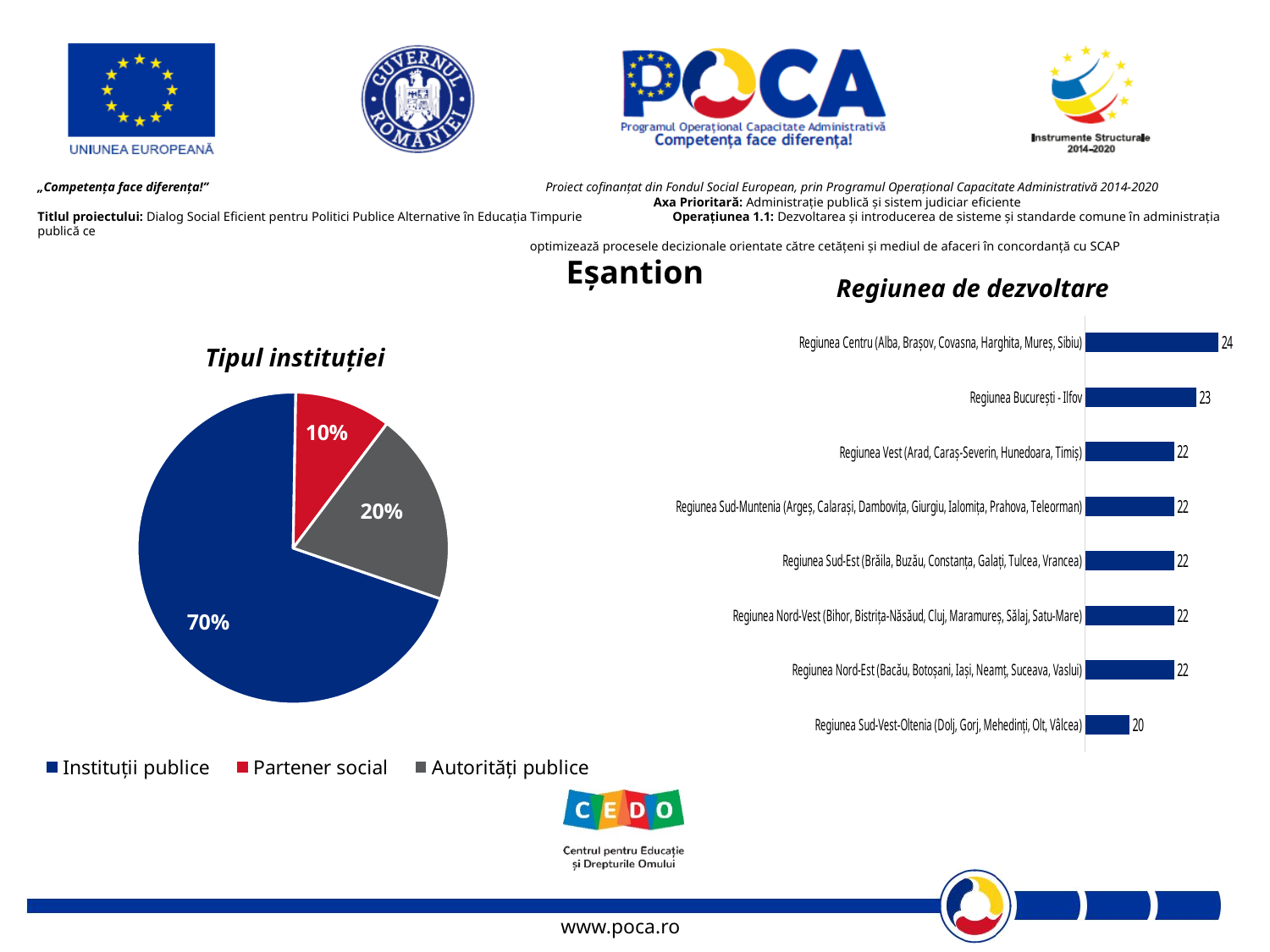
In the 'Regiunea de dezvoltare' chart, how many regions are plotted? 8 In the 'Regiunea de dezvoltare' chart, which region has the lowest value? Regiunea Sud-Vest-Oltenia In the 'Tipul instituției' pie chart, what share is shown for Instituții publice? 70% In the 'Tipul instituției' pie chart, what share is shown for Partener social? 10% What kind of chart is 'Tipul instituției'? Pie chart In the 'Tipul instituției' pie chart, how many categories does the legend list? 3 What kind of chart is 'Regiunea de dezvoltare'? Bar chart In the 'Regiunea de dezvoltare' chart, what is the value for Regiunea Centru? 24 In the 'Tipul instituției' pie chart, which category has the largest slice? Instituții publice In the 'Regiunea de dezvoltare' chart, what is the difference between Regiunea Centru and Regiunea Sud-Vest-Oltenia? 4 In the 'Regiunea de dezvoltare' chart, what is the value for Regiunea Sud-Vest-Oltenia? 20 In the 'Tipul instituției' pie chart, which category has the smallest slice? Partener social